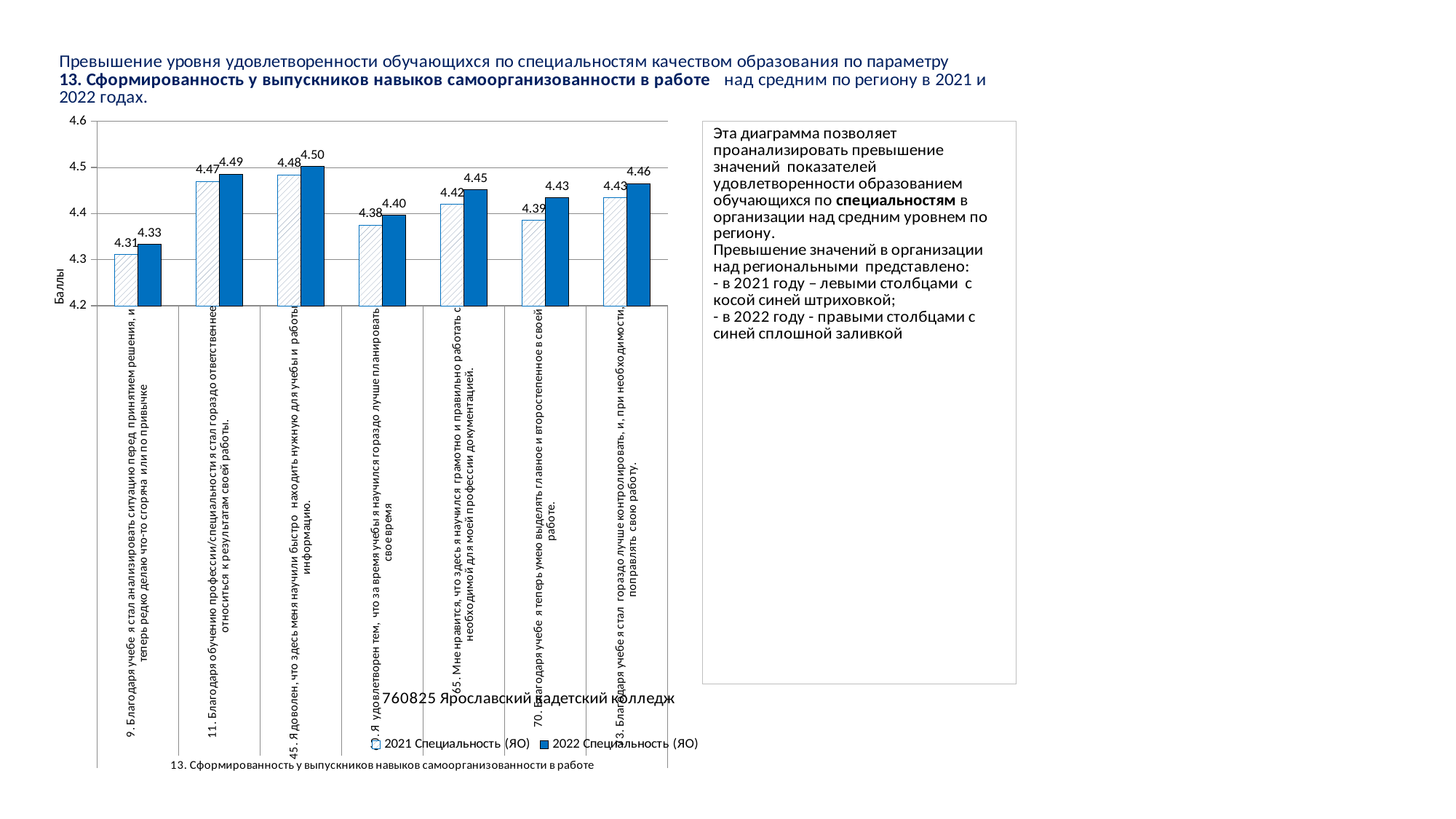
Which is larger: the 2021 value for category 11 or the 2021 value for category 65? Category 11 (4.47) Is the 2022 Специальность (ЯО) value for category 65 greater or less than 4.4? greater What type of chart is shown on the slide? Bar chart For category 70 (Благодаря учебе я теперь умею выделять главное и второстепенное в своей работе), how much higher is the 2022 value than the 2021 value? 0.04 Which category has the highest 2022 Специальность (ЯО) value? 45. Я доволен, что здесь меня научили быстро находить нужную для учебы и работы информацию How many series does the chart legend list? 2 What is the 2021 Специальность (ЯО) value for category 45 (Я доволен, что здесь меня научили быстро находить нужную для учебы и работы информацию)? 4.48 Which category has the lowest 2021 Специальность (ЯО) value? 9. Благодаря учебе я стал анализировать ситуацию перед принятием решения What is the 2021 Специальность (ЯО) value for category 65 (Мне нравится, что здесь я научился грамотно и правильно работать с документацией)? 4.42 What is the 2022 Специальность (ЯО) value for category 9 (Благодаря учебе я стал анализировать ситуацию перед принятием решения)? 4.33 What is the label of the vertical axis of the chart? Баллы How many categories (survey statements) are shown on the x axis of the chart? 7